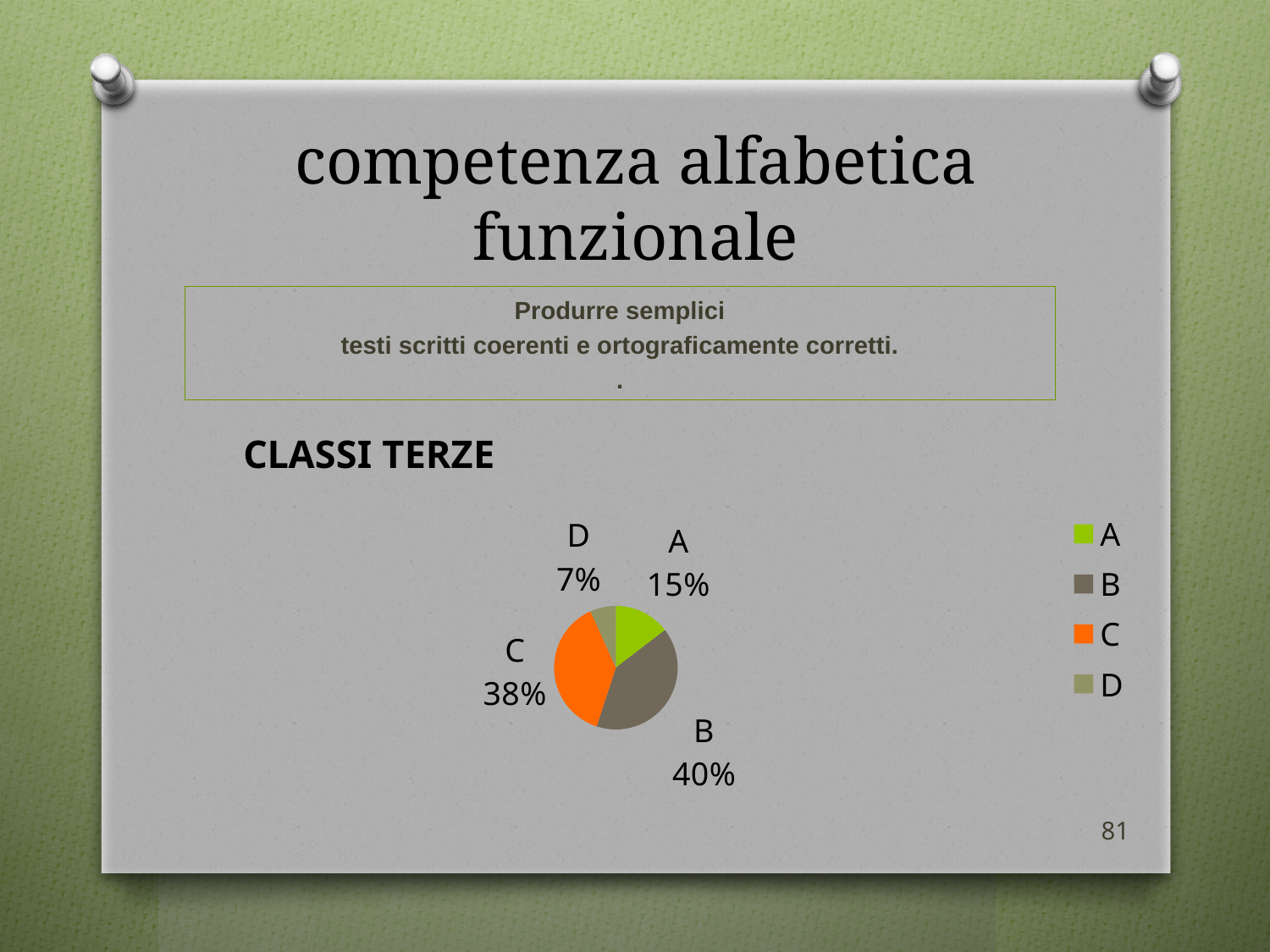
What is the difference in percentage points between slice A and slice D? 8 What percentage does slice B represent in the pie chart? 40% What is the difference in percentage points between slice B and slice C? 2 How many slices does the pie chart have? 4 Which is larger, slice A or slice C? C What kind of chart is shown on the slide? pie chart What percentage does slice D represent in the pie chart? 7% What percentage does slice C represent in the pie chart? 38% What percentage does slice A represent in the pie chart? 15% What colour is slice C in the pie chart? orange Which slice of the pie chart is the smallest? D Which slice of the pie chart is the largest? B